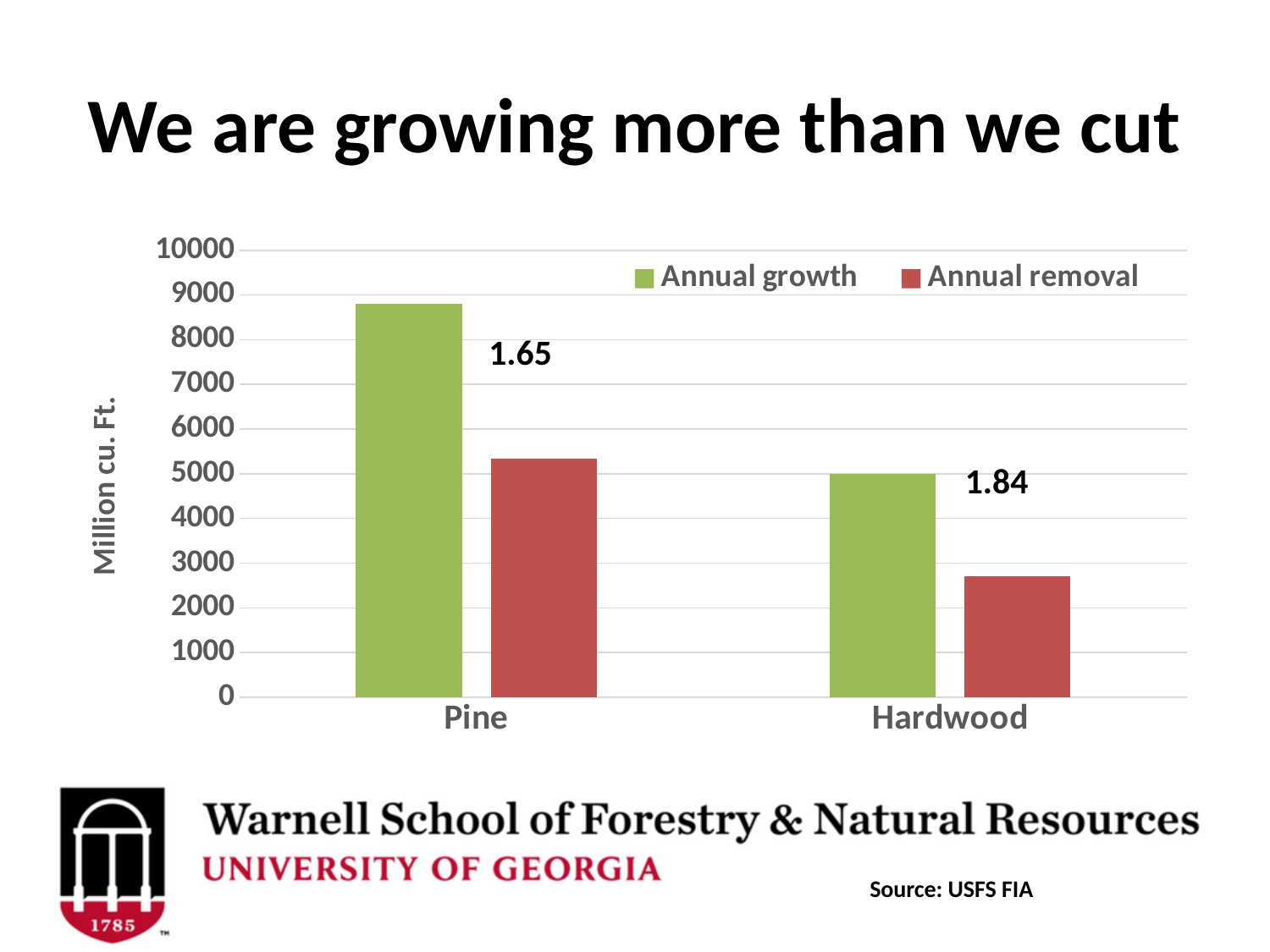
Which bar is the shortest in the chart? Annual removal for Hardwood What number is printed next to the Pine bars? 1.65 What kind of chart is shown on the slide? bar chart Which category has the larger Annual removal value, Pine or Hardwood? Pine Which bar is the tallest in the chart? Annual growth for Pine Is the Annual growth value for Pine greater or less than 8000? greater What is the label on the vertical axis? Million cu. Ft. What number is printed next to the Hardwood bars? 1.84 Is the Annual removal value for Hardwood greater or less than 3000? less How many series does the legend list? 2 How many categories are shown on the x axis? 2 What are the two series named in the legend? Annual growth and Annual removal